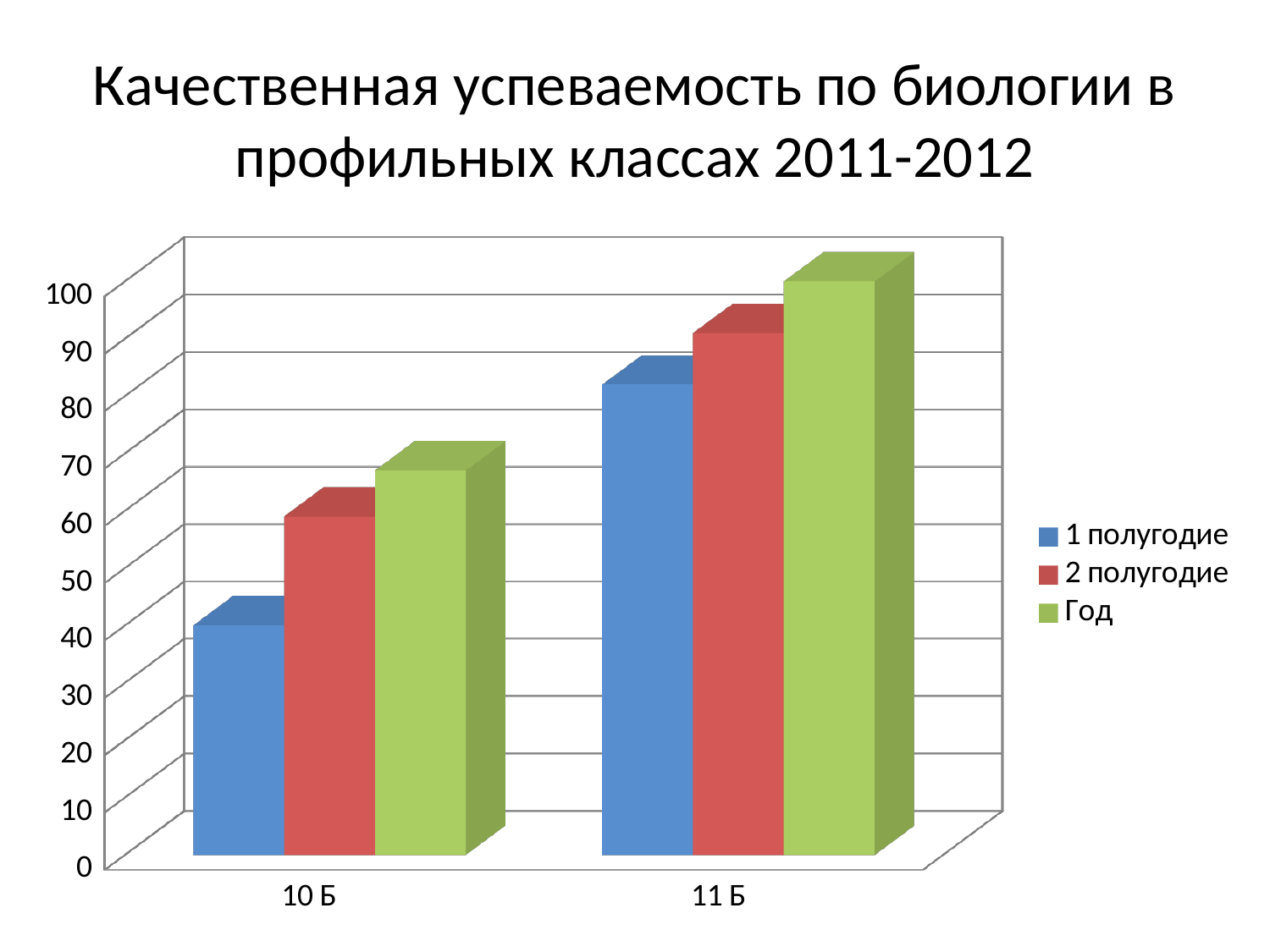
Which series has the highest value for class 11 Б? Год Is the value for 1 полугодие in class 10 Б greater or less than 50? less How many series does the legend list? 3 What is the title of the chart on the slide? Качественная успеваемость по биологии в профильных классах 2011-2012 How many classes (categories) are shown on the x axis? 2 Is the value for Год in class 10 Б greater or less than 80? less Is the value for 1 полугодие in class 11 Б greater or less than 70? greater What kind of chart is shown on the slide? bar chart Which series has the lowest value for class 10 Б? 1 полугодие Which class has the higher value for Год, 10 Б or 11 Б? 11 Б Which class has the higher value for 1 полугодие, 10 Б or 11 Б? 11 Б